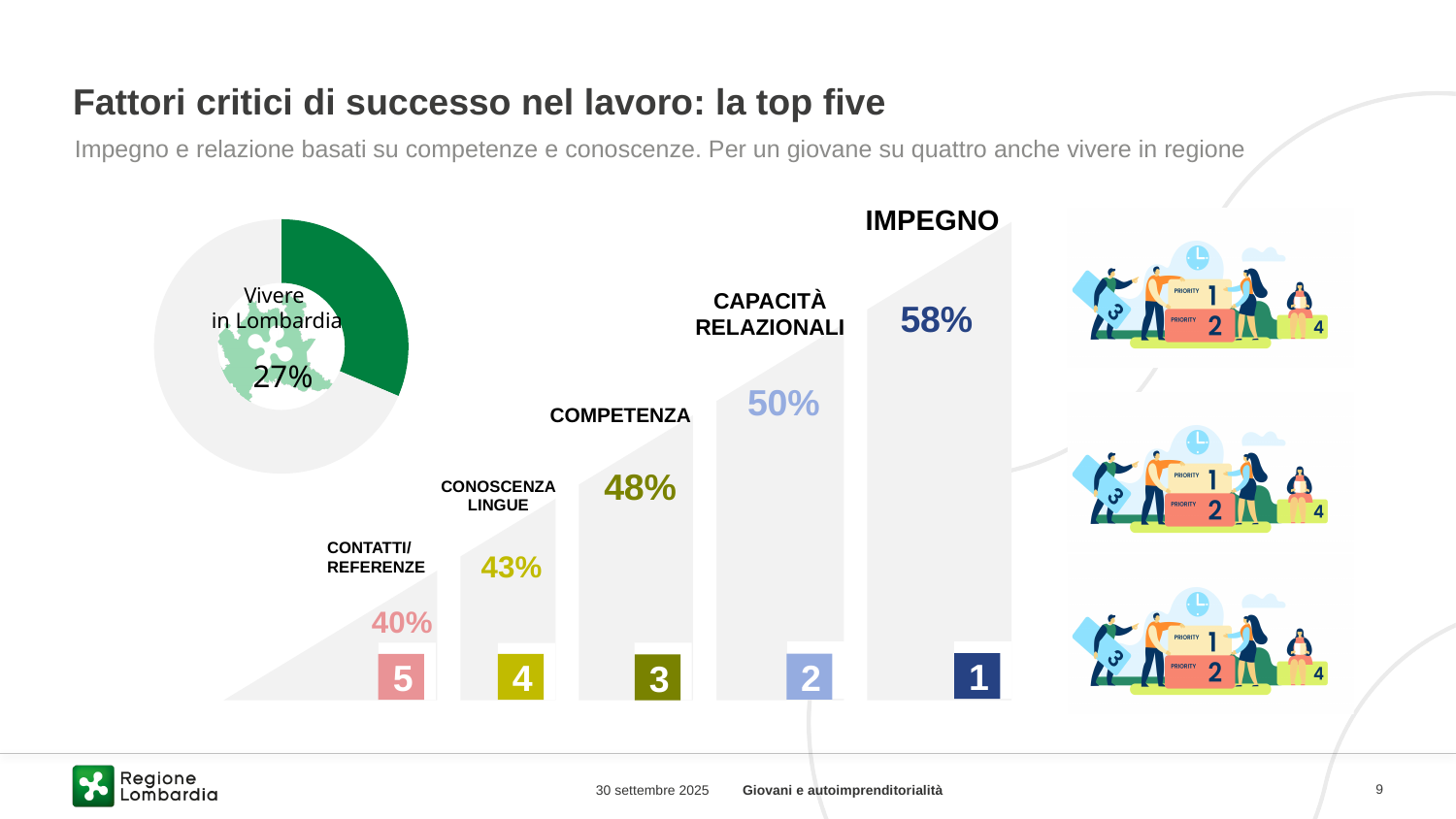
In the ranked bar chart in the centre of the slide, which factor has the lowest value? CONTATTI/REFERENZE In the ranked bar chart in the centre of the slide, what is the difference between the values for IMPEGNO and CAPACITÀ RELAZIONALI? 8% In the donut chart on the left of the slide, what share is shown for 'Vivere in Lombardia'? 27% In the ranked bar chart in the centre of the slide, which factor has the highest value? IMPEGNO In the ranked bar chart in the centre of the slide, which rank number is shown under CAPACITÀ RELAZIONALI? 2 In the ranked bar chart in the centre of the slide, do the values rise or fall from rank 5 on the left to rank 1 on the right? rise What kind of chart is the 'Vivere in Lombardia' chart on the left of the slide? donut chart In the ranked bar chart in the centre of the slide, which is larger: the value for COMPETENZA or the value for CONTATTI/REFERENZE? COMPETENZA How many factors are shown in the ranked bar chart in the centre of the slide? 5 In the ranked bar chart in the centre of the slide, what is the value for COMPETENZA? 48% In the ranked bar chart in the centre of the slide, what is the value for IMPEGNO? 58% In the ranked bar chart in the centre of the slide, what is the value for CONOSCENZA LINGUE? 43%